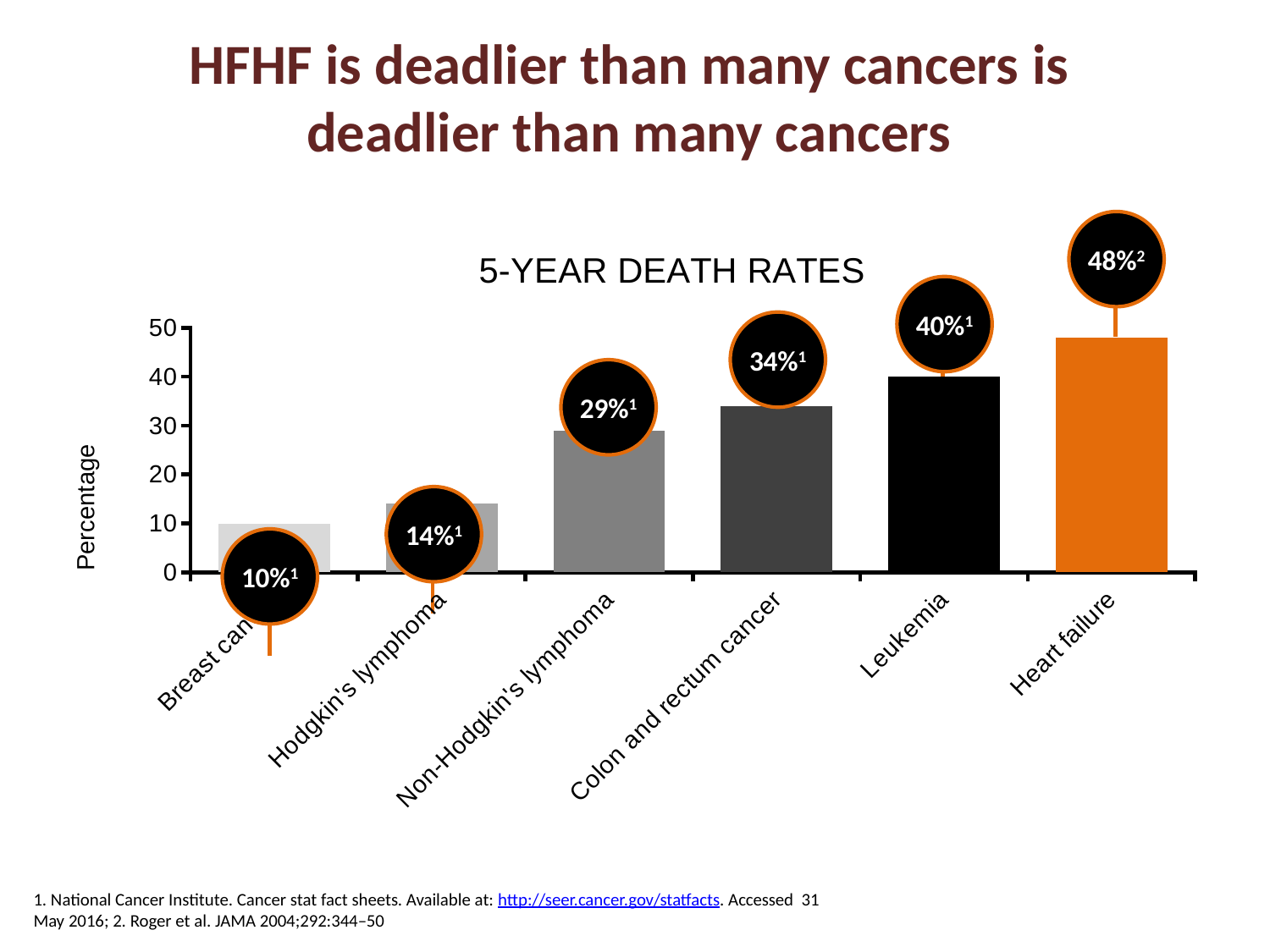
How many categories are plotted in the chart? 6 Which category has the lowest 5-year death rate? Breast cancer What kind of chart is shown on the slide? Bar chart What is the 5-year death rate shown for Heart failure? 48% What is the 5-year death rate shown for Non-Hodgkin's lymphoma? 29% What is the title of the chart? 5-YEAR DEATH RATES What is the difference between the 5-year death rates for Heart failure and Leukemia? 8% What is the 5-year death rate shown for Colon and rectum cancer? 34% Which category has the highest 5-year death rate? Heart failure What is the 5-year death rate shown for Leukemia? 40% What is the 5-year death rate shown for Hodgkin's lymphoma? 14% Which has a higher 5-year death rate, Colon and rectum cancer or Non-Hodgkin's lymphoma? Colon and rectum cancer